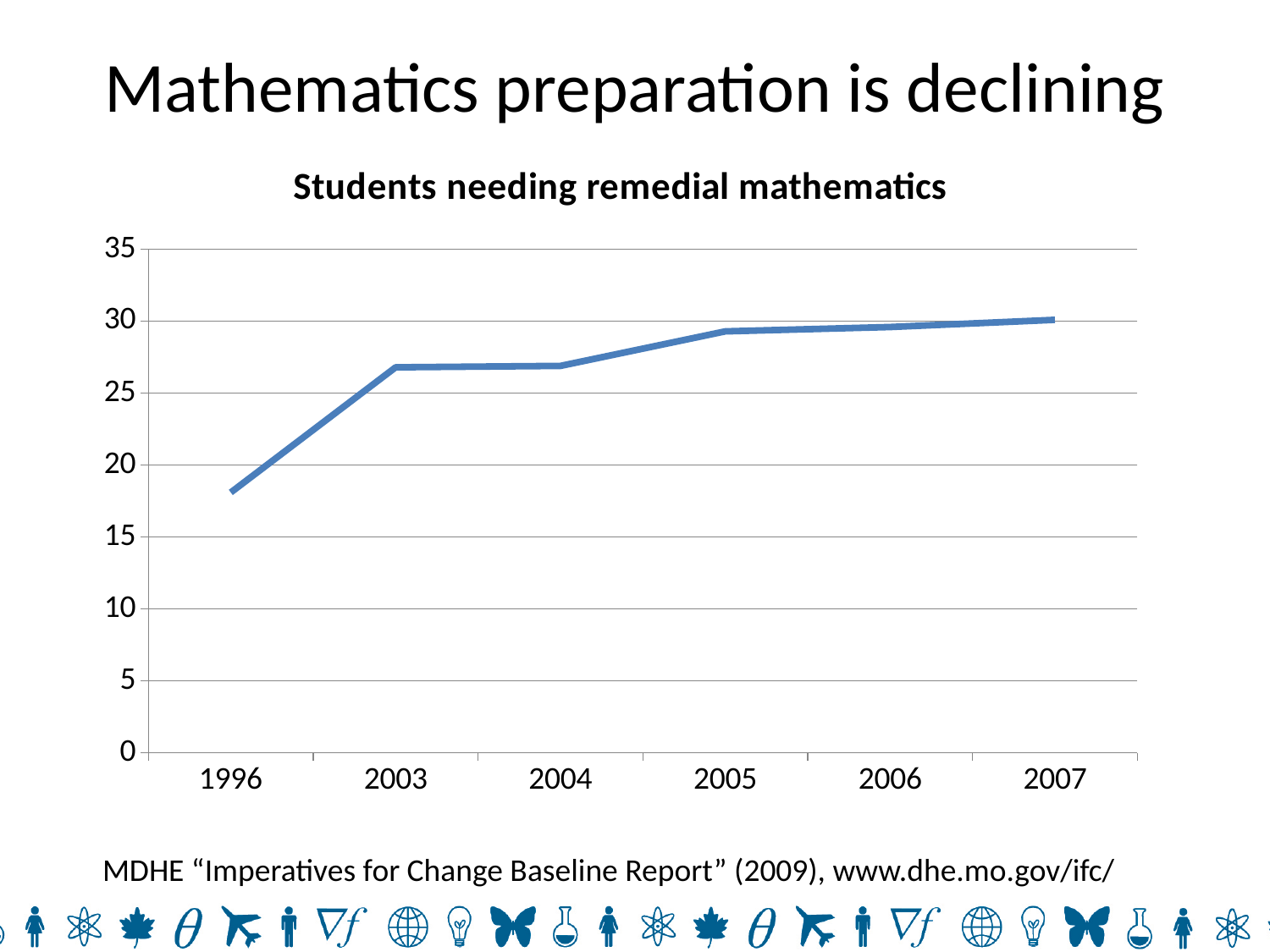
Is the value for 2004 greater or less than 30? less Which is larger, the value for 2004 or the value for 2005? 2005 Is the value for 2003 greater or less than 25? greater Which is larger, the value for 1996 or the value for 2003? 2003 Do the values rise or fall from 1996 to 2007? rise How many years are plotted on the x axis? 6 Which year has the lowest value for students needing remedial mathematics? 1996 What kind of chart is shown on the slide? line chart Is the value for 2005 greater or less than 25? greater What is the title of the chart? Students needing remedial mathematics